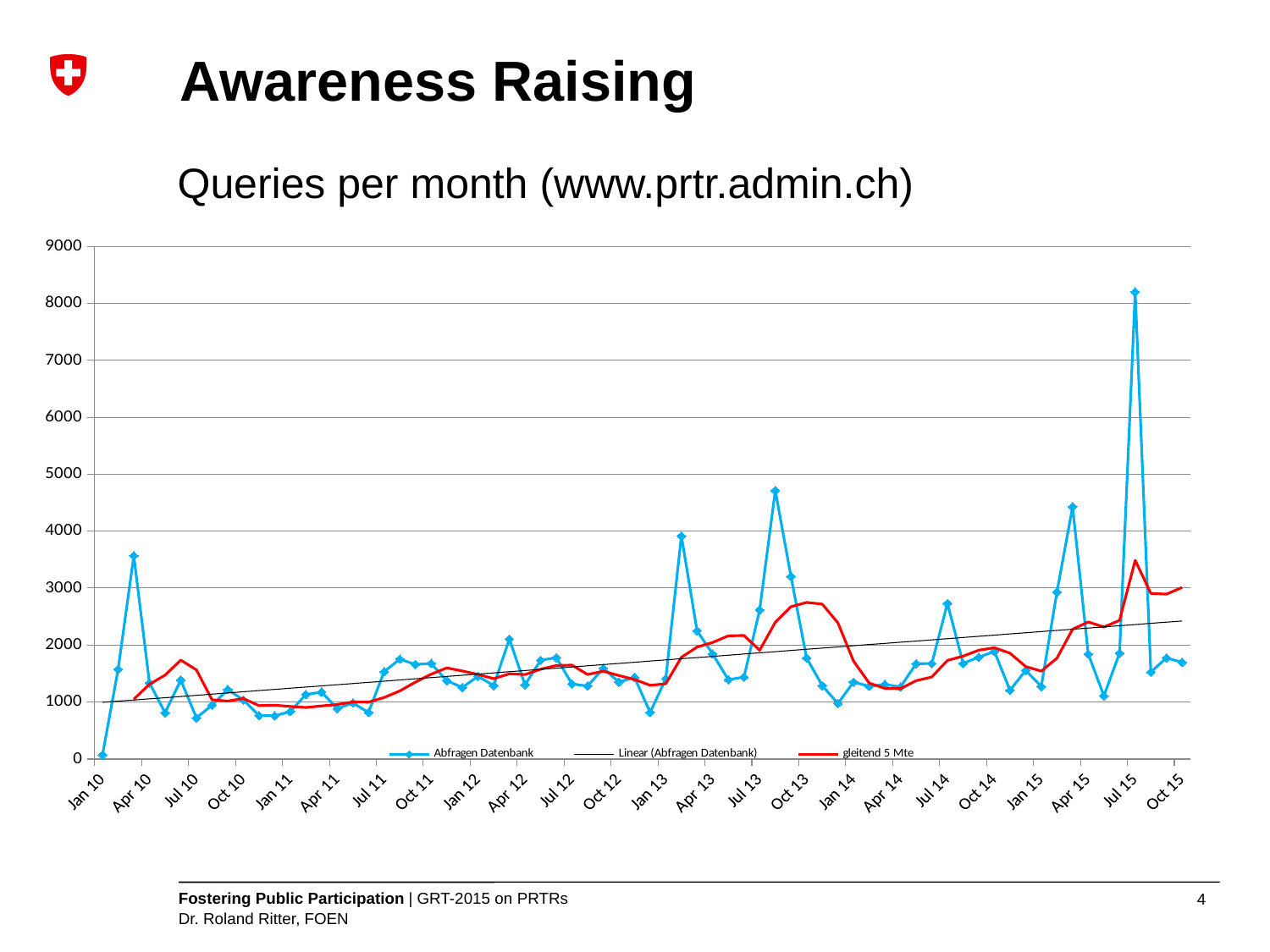
Which series is drawn in red? gleitend 5 Mte Is the value of Abfragen Datenbank for Apr 10 greater or less than 3000? less Which is larger for Abfragen Datenbank, the value for Apr 10 or the value for Jul 10? Apr 10 What is the title of the chart? Queries per month (www.prtr.admin.ch) Which month has the lowest value of Abfragen Datenbank? Jan 10 Does the linear trend line (Linear (Abfragen Datenbank)) rise or fall from Jan 10 to Oct 15? rise Is the highest value of the Abfragen Datenbank series greater or less than 8000? greater How many series does the legend list? 3 Is the value of Abfragen Datenbank for Jan 10 greater or less than 1000? less How many month labels are shown on the x axis? 24 What kind of chart is shown on the slide? line chart